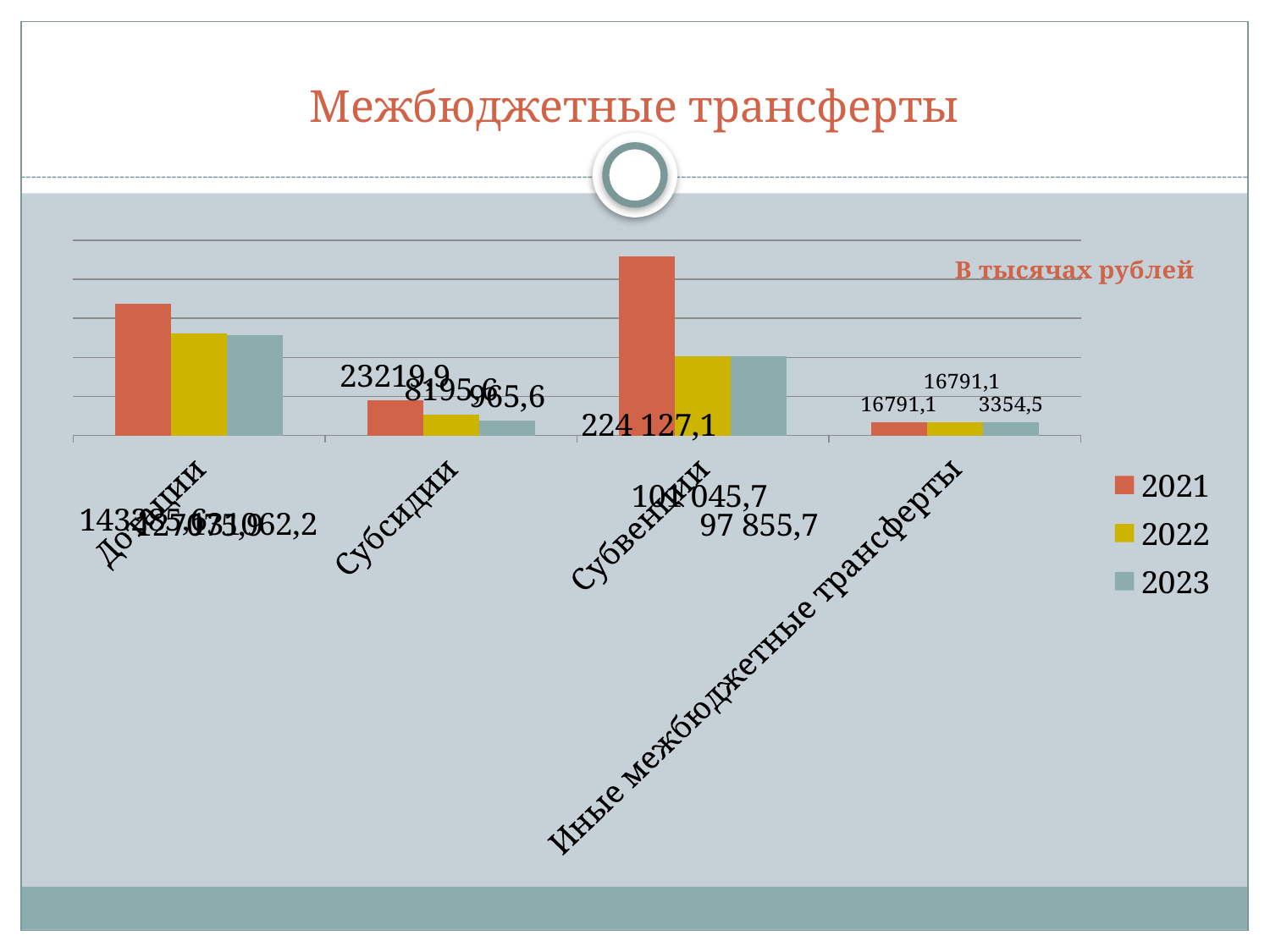
What is the difference between the 2021 and 2023 values for Иные межбюджетные трансферты? 13436,6 What kind of chart is shown on the slide? Bar chart Which is larger for Субвенции: the 2021 value or the 2022 value? 2021 How many series does the legend list? 3 What is the value for Субсидии in 2021? 23219,9 Do the values for Субсидии rise or fall from 2021 to 2023? Fall What is the value for Субвенции in 2023? 97 855,7 Which category has the highest value for 2021? Субвенции What is the value for Иные межбюджетные трансферты in 2023? 3354,5 What is the value for Субвенции in 2022? 101 045,7 How many categories are shown on the x axis? 4 What is the value for Субвенции in 2021? 224 127,1